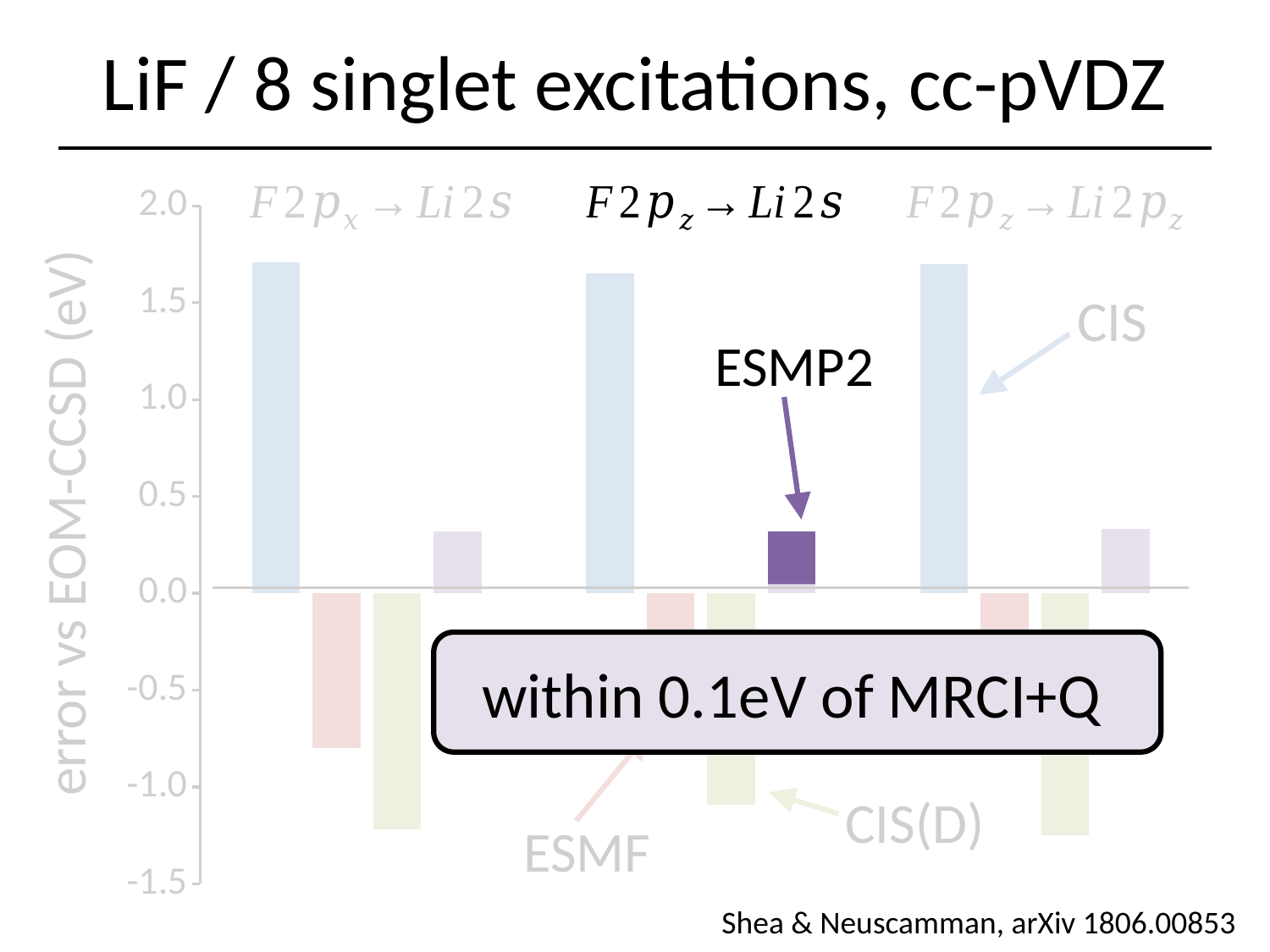
How many methods (bar series) are labelled on the chart? 4 For the F2pz→Li2s excitation, which has the larger error, CIS or ESMP2? CIS Is the CIS(D) error for the F2px→Li2s excitation greater or less than -1.0 eV? less What kind of chart is shown on the slide? bar chart Which method has the most negative error across the excitations shown? CIS(D) Is the CIS error for the F2px→Li2s excitation greater or less than 1.5 eV? greater Is the ESMF error for the F2px→Li2s excitation greater or less than -1.0 eV? greater What is the label of the y axis? error vs EOM-CCSD (eV) How many excitation groups are shown along the x axis? 3 Which method has the largest positive error across the excitations shown? CIS Which method is highlighted with a solid purple bar on the chart? ESMP2